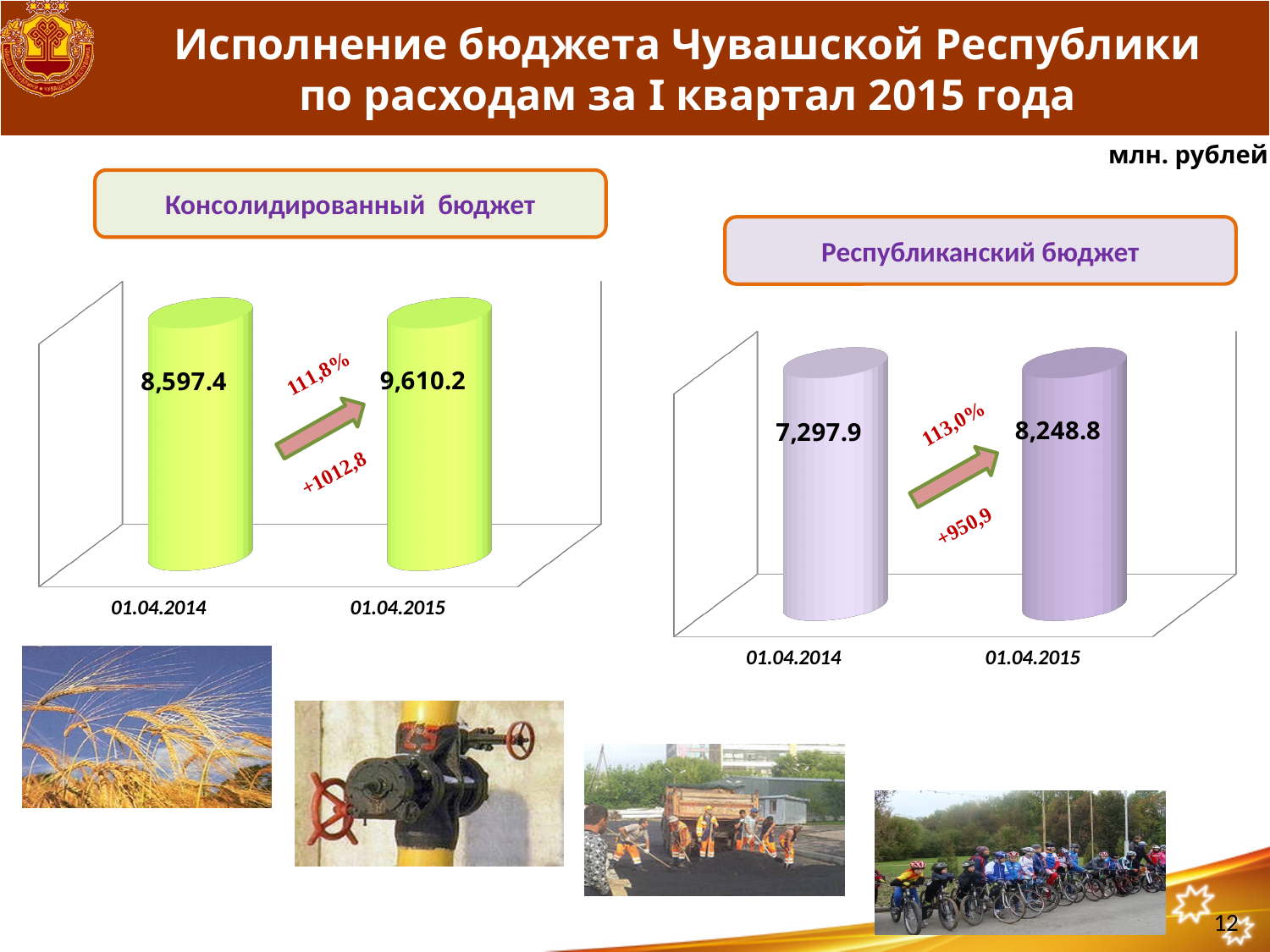
In the 'Консолидированный бюджет' chart, what is the value for 01.04.2014? 8,597.4 In the 'Республиканский бюджет' chart, is the value for 01.04.2015 larger or smaller than the value for 01.04.2014? larger In the 'Консолидированный бюджет' chart, what is the value for 01.04.2015? 9,610.2 In the 'Республиканский бюджет' chart, which date has the lower value? 01.04.2014 What type of chart is the 'Республиканский бюджет' chart? bar chart In the 'Консолидированный бюджет' chart, what is the difference between the 01.04.2015 and 01.04.2014 values? 1,012.8 In the 'Консолидированный бюджет' chart, which date has the higher value? 01.04.2015 In the 'Республиканский бюджет' chart, what is the value for 01.04.2015? 8,248.8 How many bars are shown in the 'Консолидированный бюджет' chart? 2 In the 'Республиканский бюджет' chart, what is the value for 01.04.2014? 7,297.9 What growth percentage is shown on the arrow in the 'Республиканский бюджет' chart? 113,0% In the 'Республиканский бюджет' chart, what is the difference between the 01.04.2015 and 01.04.2014 values? 950.9